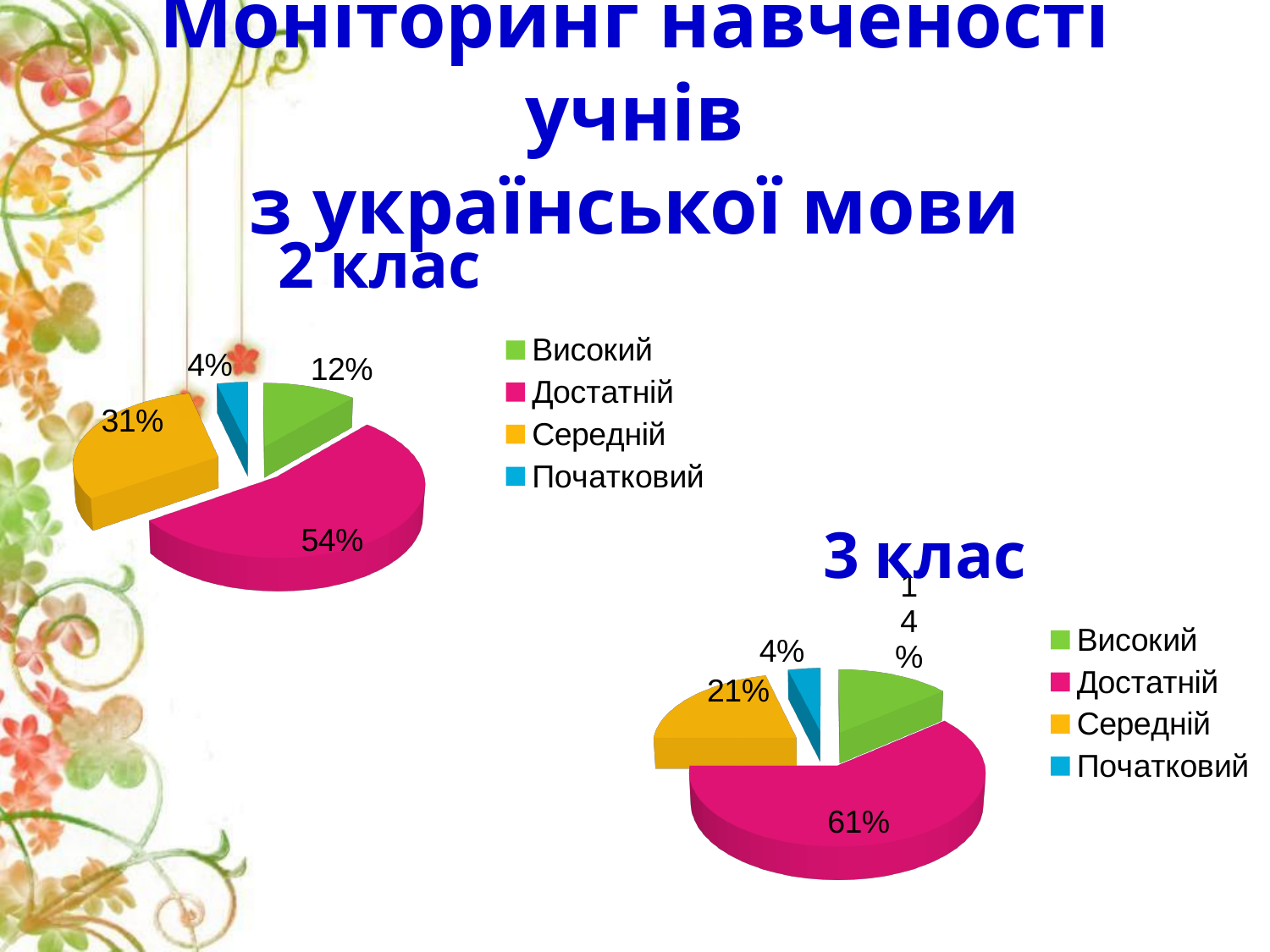
In the "2 клас" chart legend, which colour represents Початковий? Blue What type of chart is used for "2 клас"? Pie chart In the "3 клас" pie chart, what is the difference between the Достатній and Високий shares? 47% In the "3 клас" pie chart, what percentage is shown for Середній? 21% In the "3 клас" pie chart, what percentage is shown for Достатній? 61% In the "2 клас" pie chart, what percentage is shown for Достатній? 54% In the "2 клас" pie chart, what percentage is shown for Середній? 31% In the "3 клас" pie chart, which category has the smallest share? Початковий In the "2 клас" pie chart, which category has the largest share? Достатній In the "2 клас" pie chart, what is the difference between the Достатній and Середній shares? 23% Which is larger: the Середній share in the "2 клас" chart or the Середній share in the "3 клас" chart? 2 клас How many categories does the "3 клас" pie chart show? 4